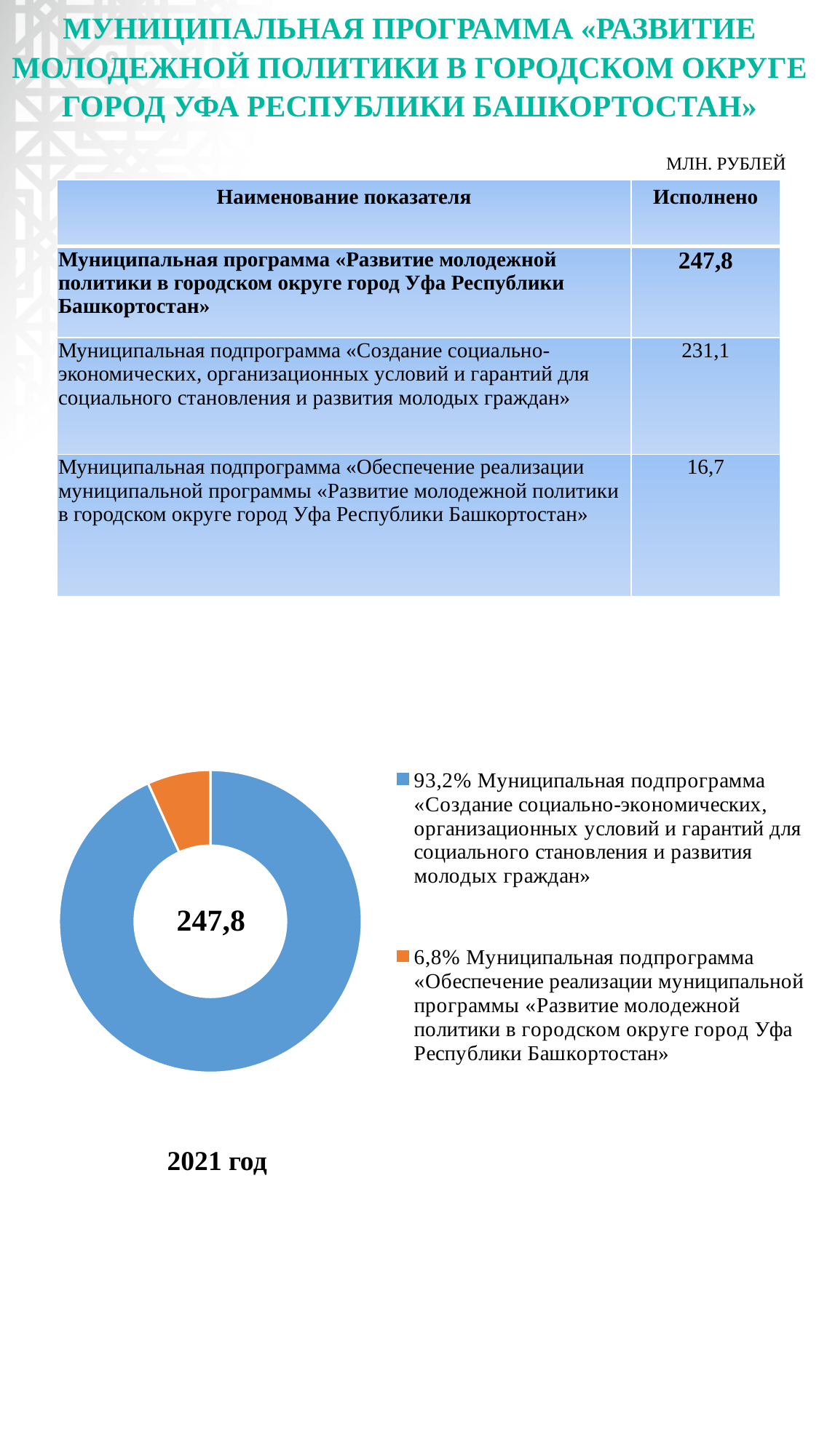
Which year is indicated below the doughnut chart? 2021 год Which slice of the doughnut chart is the largest? Муниципальная подпрограмма «Создание социально-экономических, организационных условий и гарантий для социального становления и развития молодых граждан» What kind of chart is shown on the slide? Doughnut (pie) chart Which slice is larger: the blue one or the orange one? The blue one Which slice of the doughnut chart is the smallest? Муниципальная подпрограмма «Обеспечение реализации муниципальной программы «Развитие молодежной политики в городском округе город Уфа Республики Башкортостан» What is the difference in percentage points between the two slices of the doughnut chart? 86,4 What share of the doughnut chart does the subprogram «Обеспечение реализации муниципальной программы «Развитие молодежной политики в городском округе город Уфа Республики Башкортостан» take? 6,8% How many slices does the doughnut chart have? 2 How many entries does the legend of the doughnut chart list? 2 What share of the doughnut chart does the subprogram «Создание социально-экономических, организационных условий и гарантий для социального становления и развития молодых граждан» take? 93,2% What colour is the slice for the subprogram «Обеспечение реализации муниципальной программы...» in the doughnut chart? Orange What value is printed in the centre of the doughnut chart? 247,8